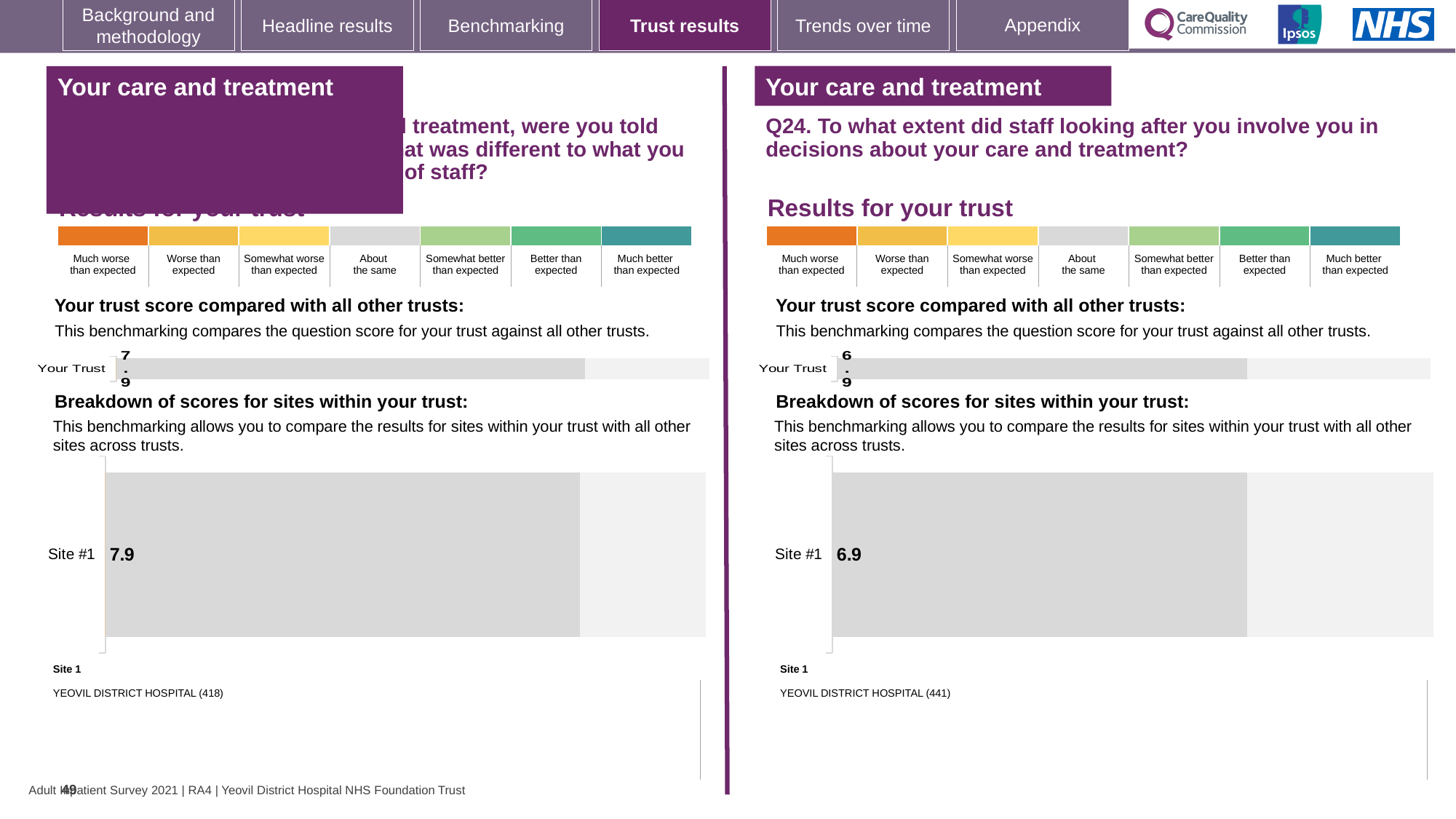
What is the difference between the Your Trust score on the left half of the slide and the Your Trust score on the right half? 1.0 On the right half of the slide (Q24), what is the score shown for Your Trust in the 'Your trust score compared with all other trusts' chart? 6.9 Is the Your Trust score on the right half of the slide (Q24) greater or less than the Your Trust score on the left half? less What is the name of Site 1 listed below the left breakdown chart? YEOVIL DISTRICT HOSPITAL (418) What kind of chart is used to show the Site #1 score on the right half of the slide? Bar chart In the left 'Breakdown of scores for sites within your trust' chart, what is the score for Site #1? 7.9 Which is larger: the Site #1 score in the left breakdown chart or the Site #1 score in the right breakdown chart? Left (7.9) What is the name of Site 1 listed below the right breakdown chart? YEOVIL DISTRICT HOSPITAL (441) How many sites are shown in the right 'Breakdown of scores for sites within your trust' chart? 1 How many sites are shown in the left 'Breakdown of scores for sites within your trust' chart? 1 On the left half of the slide, what is the score shown for Your Trust in the 'Your trust score compared with all other trusts' chart? 7.9 In the right 'Breakdown of scores for sites within your trust' chart (Q24), what is the score for Site #1? 6.9